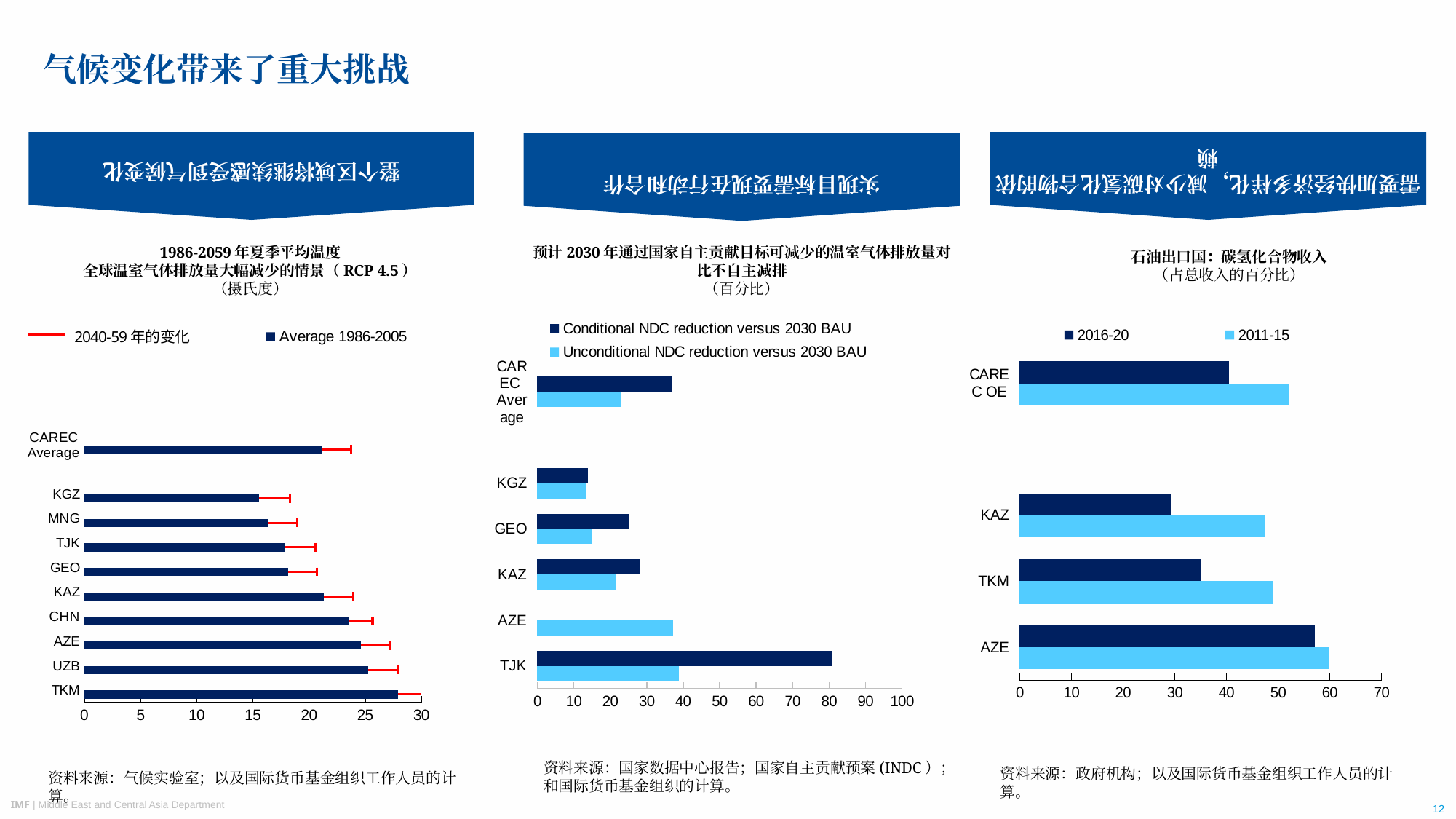
In the middle chart (预计 2030 年通过国家自主贡献目标可减少的温室气体排放量), which is larger for GEO: the Conditional or the Unconditional NDC reduction? Conditional In the left chart (1986-2059 年夏季平均温度), which country has the lowest Average 1986-2005 value? KGZ In the middle chart (预计 2030 年通过国家自主贡献目标可减少的温室气体排放量), which country has the highest Conditional NDC reduction versus 2030 BAU? TJK In the left chart (1986-2059 年夏季平均温度), which country has the highest Average 1986-2005 value? TKM In the right chart (石油出口国：碳氢化合物收入), which country has the highest 2016-20 value? AZE In the right chart (石油出口国：碳氢化合物收入), is the 2011-15 value for KAZ greater or less than 40? greater In the left chart (1986-2059 年夏季平均温度), is the Average 1986-2005 value for TKM greater or less than 25? greater In the middle chart (预计 2030 年通过国家自主贡献目标可减少的温室气体排放量), is the Conditional NDC reduction for TJK greater or less than 70? greater In the middle chart (预计 2030 年通过国家自主贡献目标可减少的温室气体排放量), how many series does the legend list? 2 In the left chart (1986-2059 年夏季平均温度), how many categories are plotted on the vertical axis? 10 What type of chart is the right chart (石油出口国：碳氢化合物收入)? Bar chart